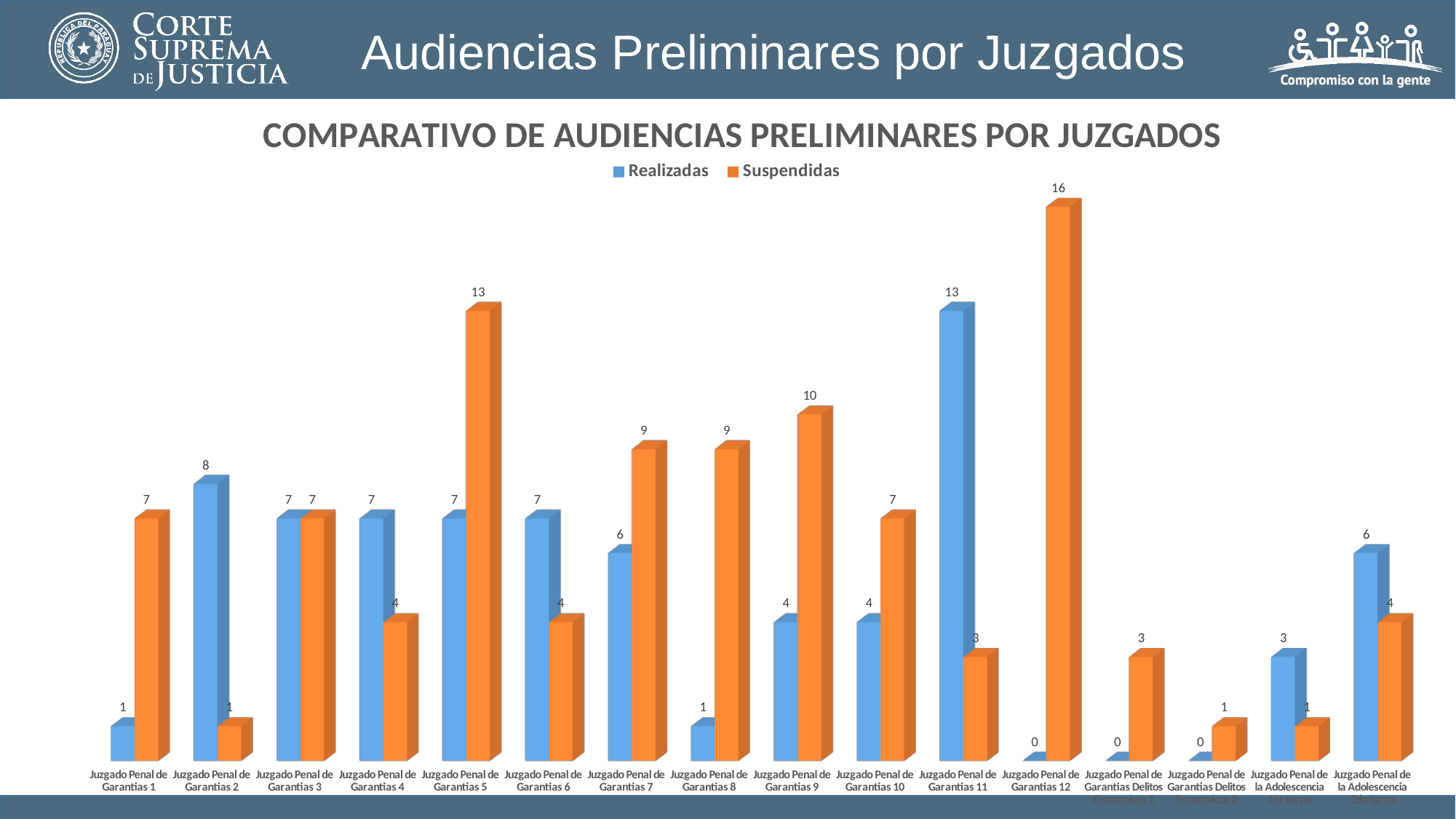
Which juzgado has the highest Realizadas value? Juzgado Penal de Garantias 11 For Juzgado Penal de Garantias 2, which is larger: Realizadas or Suspendidas? Realizadas What is the Suspendidas value for Juzgado Penal de Garantias 12? 16 What type of chart is shown on the slide? Bar chart How many series does the legend list? 2 Which juzgado has the highest Suspendidas value? Juzgado Penal de Garantias 12 What is the Realizadas value for Juzgado Penal de Garantias 12? 0 For Juzgado Penal de Garantias 5, what is the difference between Suspendidas and Realizadas? 6 How many juzgados (categories) are shown on the x axis? 16 What are the two legend entries of the chart? Realizadas and Suspendidas What is the Realizadas value for Juzgado Penal de Garantias 11? 13 For Juzgado Penal de Garantias 8, what is the difference between Suspendidas and Realizadas? 8